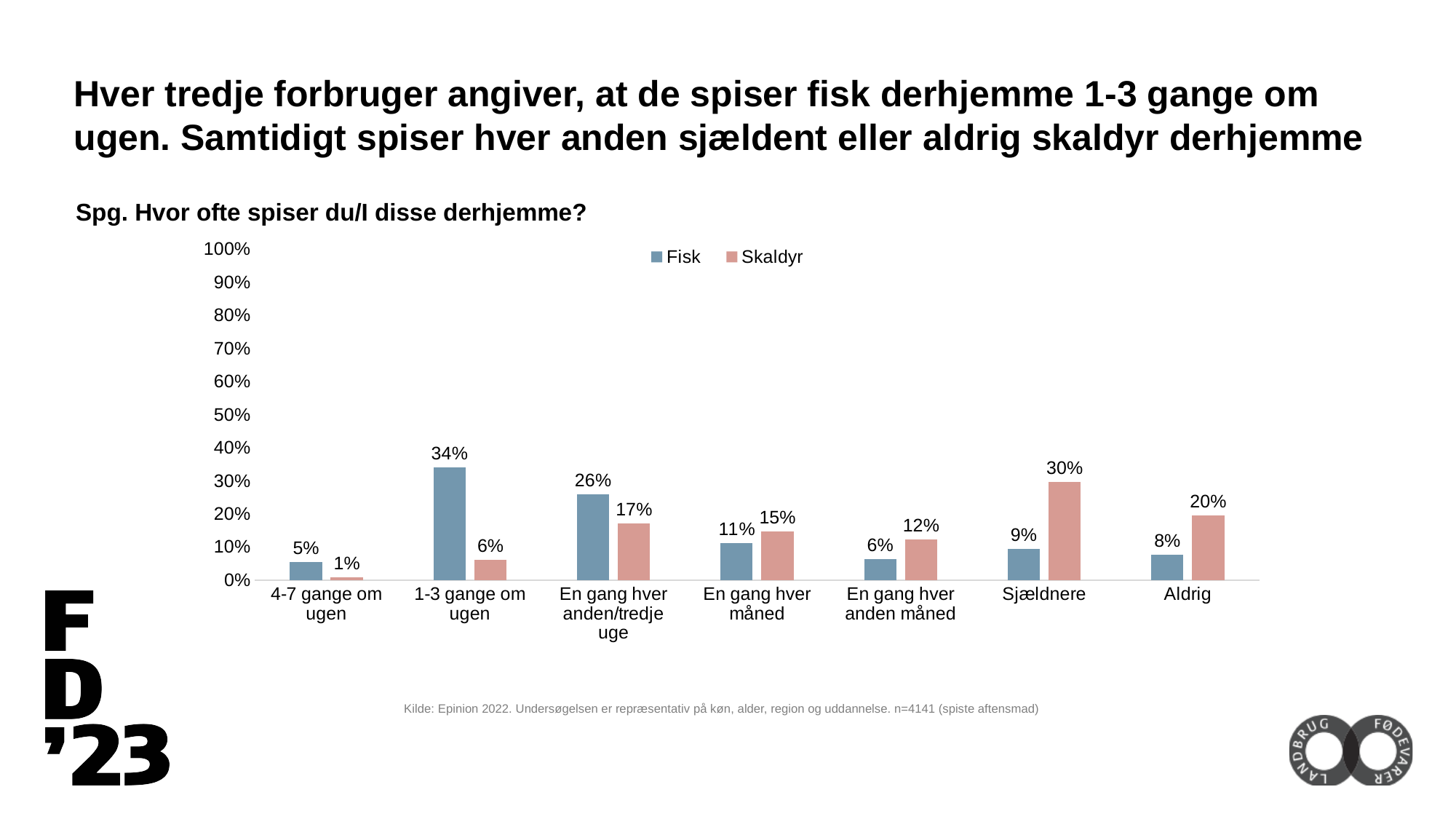
Which category has the highest Fisk value? 1-3 gange om ugen What is the Fisk value for '1-3 gange om ugen'? 34% Which category has the lowest Skaldyr value? 4-7 gange om ugen What is the Skaldyr value for 'Sjældnere'? 30% How many series does the legend list? 2 What are the two series named in the legend? Fisk and Skaldyr What is the Skaldyr value for '4-7 gange om ugen'? 1% Is the Fisk value for '1-3 gange om ugen' greater or less than 30%? greater What kind of chart is shown on the slide? Bar chart What is the difference between the Fisk and Skaldyr values for 'Aldrig'? 12% For 'En gang hver anden/tredje uge', which is larger, Fisk or Skaldyr? Fisk How many categories are shown on the x axis? 7